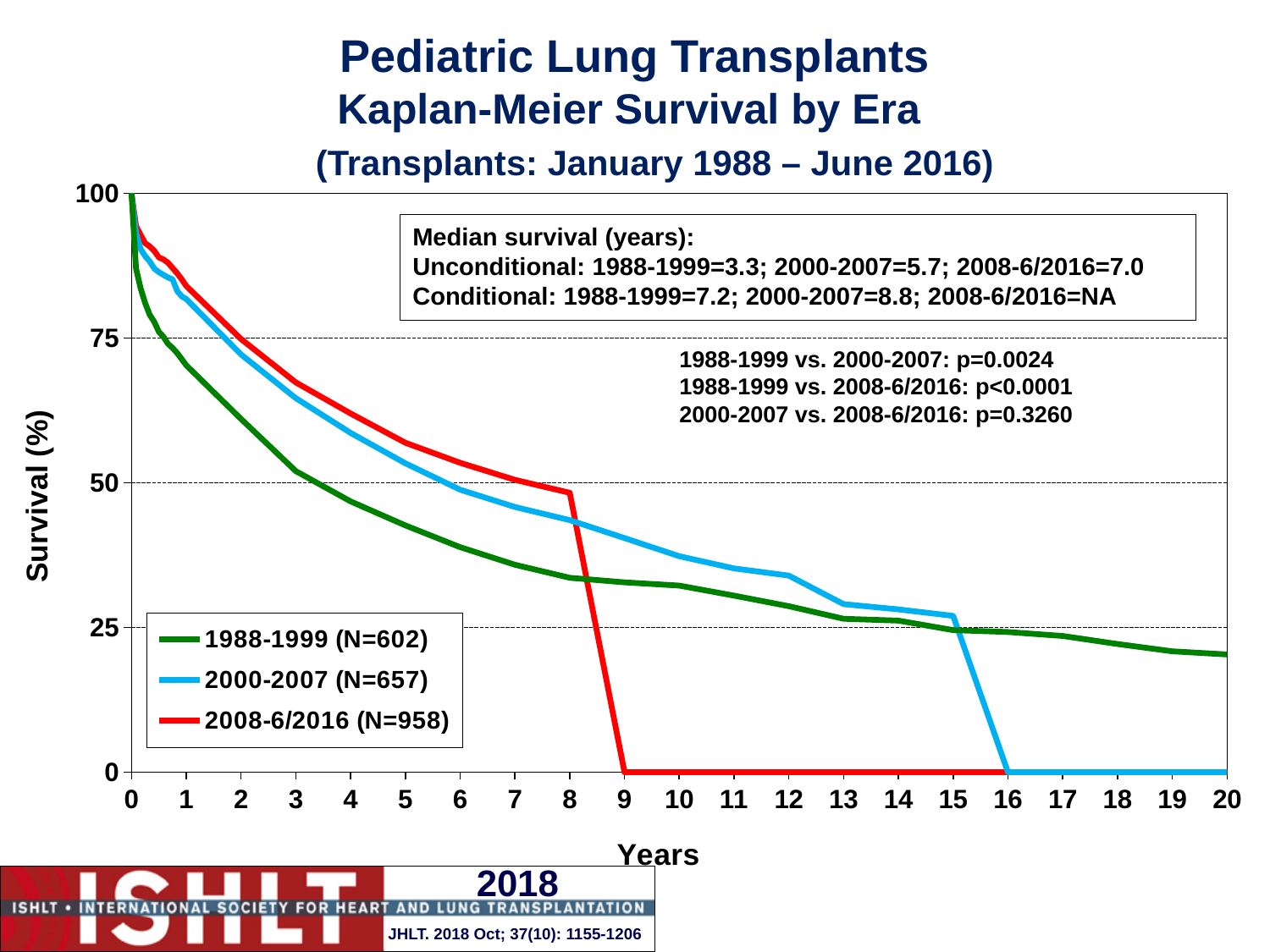
What is the p-value for 1988-1999 vs. 2000-2007? p=0.0024 What kind of chart is shown on the slide? line chart What is the number of patients (N) for the 2008-6/2016 era shown in the legend? 958 How many series does the legend list? 3 Is the survival value for the 1988-1999 era at 5 years greater or less than 50? less What is the number of patients (N) for the 1988-1999 era shown in the legend? 602 What is the conditional median survival in years for the 2000-2007 era? 8.8 Is the survival value for the 2008-6/2016 era at 4 years greater or less than 50? greater Do the survival curves rise or fall as years increase along the x axis? fall At 5 years, which era has higher survival: 2008-6/2016 or 1988-1999? 2008-6/2016 What is the unconditional median survival in years for the 2008-6/2016 era? 7.0 What colour is the line for the 2008-6/2016 era? red